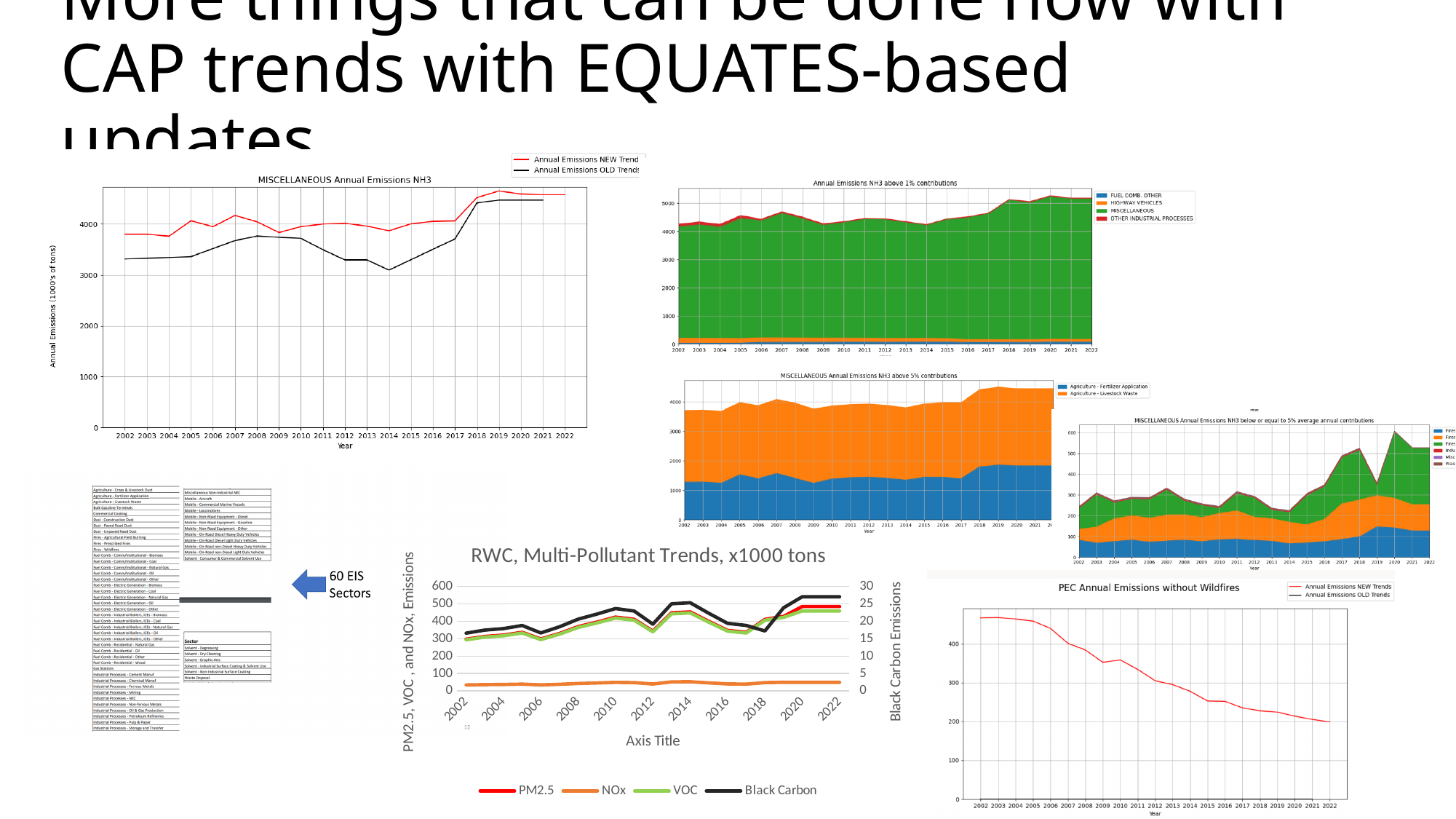
In the "PEC Annual Emissions without Wildfires" chart, is the value for 2022 greater or less than 300? less How many series does the legend of the "RWC, Multi-Pollutant Trends, x1000 tons" chart list? 4 In the "RWC, Multi-Pollutant Trends, x1000 tons" chart, which series has the lowest plotted line across the years? NOx In the "MISCELLANEOUS Annual Emissions NH3" chart, which series is larger in 2014, Annual Emissions NEW Trends or Annual Emissions OLD Trends? Annual Emissions NEW Trends How many series does the legend of the "MISCELLANEOUS Annual Emissions NH3 above 5% contributions" chart list? 2 What is the x-axis title of the "RWC, Multi-Pollutant Trends, x1000 tons" chart? Axis Title How many series does the legend of the "Annual Emissions NH3 above 1% contributions" chart list? 4 What kind of chart is the "MISCELLANEOUS Annual Emissions NH3" chart at the top left? line chart In the "PEC Annual Emissions without Wildfires" chart, do the values rise or fall from 2002 to 2022? fall In the "PEC Annual Emissions without Wildfires" chart, is the value for 2002 greater or less than 400? greater In the "MISCELLANEOUS Annual Emissions NH3" chart, is the Annual Emissions OLD Trends value for 2014 greater or less than 4000? less